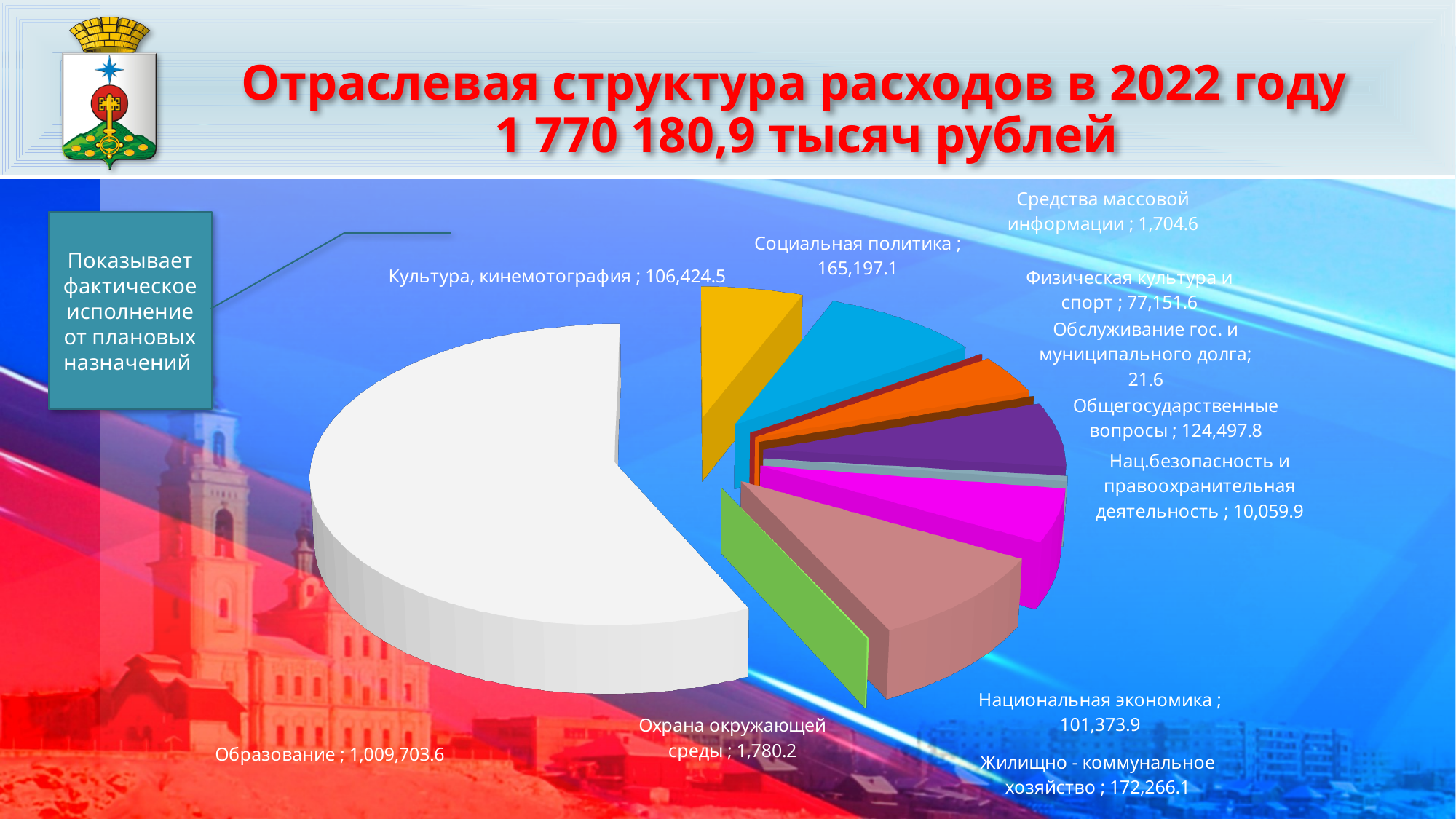
What is the difference between Культура, кинемотография and Национальная экономика? 5,050.6 What type of chart is shown on the slide? Pie chart What is the value for Социальная политика? 165,197.1 Which category has the smallest value? Обслуживание гос. и муниципального долга What is the value for Образование? 1,009,703.6 What is the value for Жилищно - коммунальное хозяйство? 172,266.1 What total amount of expenditure is stated in the slide title? 1 770 180,9 тысяч рублей Which is larger: Социальная политика or Общегосударственные вопросы? Социальная политика What is the value for Обслуживание гос. и муниципального долга? 21.6 How many categories are shown in the pie chart? 11 Which category has the largest value? Образование What is the difference between Жилищно - коммунальное хозяйство and Социальная политика? 7,069.0